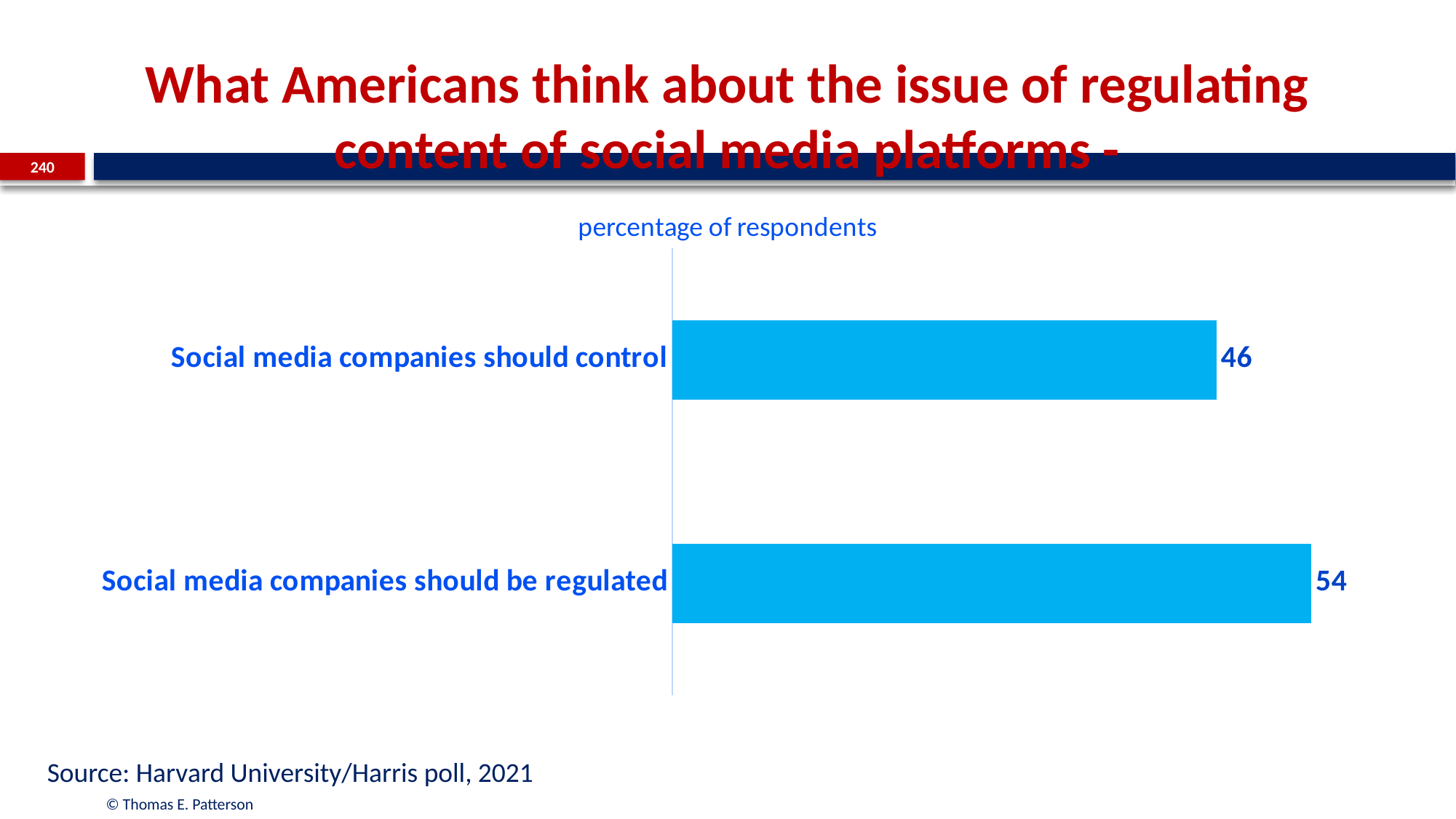
Which category has the lower value? Social media companies should control What percentage of respondents said social media companies should be regulated? 54 What is the source of the data shown in the chart? Harvard University/Harris poll, 2021 How many categories are shown in the chart? 2 What type of chart is shown on the slide? bar chart Is the value for 'Social media companies should control' larger or smaller than the value for 'Social media companies should be regulated'? smaller Which category has the higher value? Social media companies should be regulated What is the chart's subtitle describing the unit of the values? percentage of respondents What percentage of respondents said social media companies should control content? 46 What is the difference between the value for 'should be regulated' and the value for 'should control'? 8 What is the total of the two values shown in the chart? 100